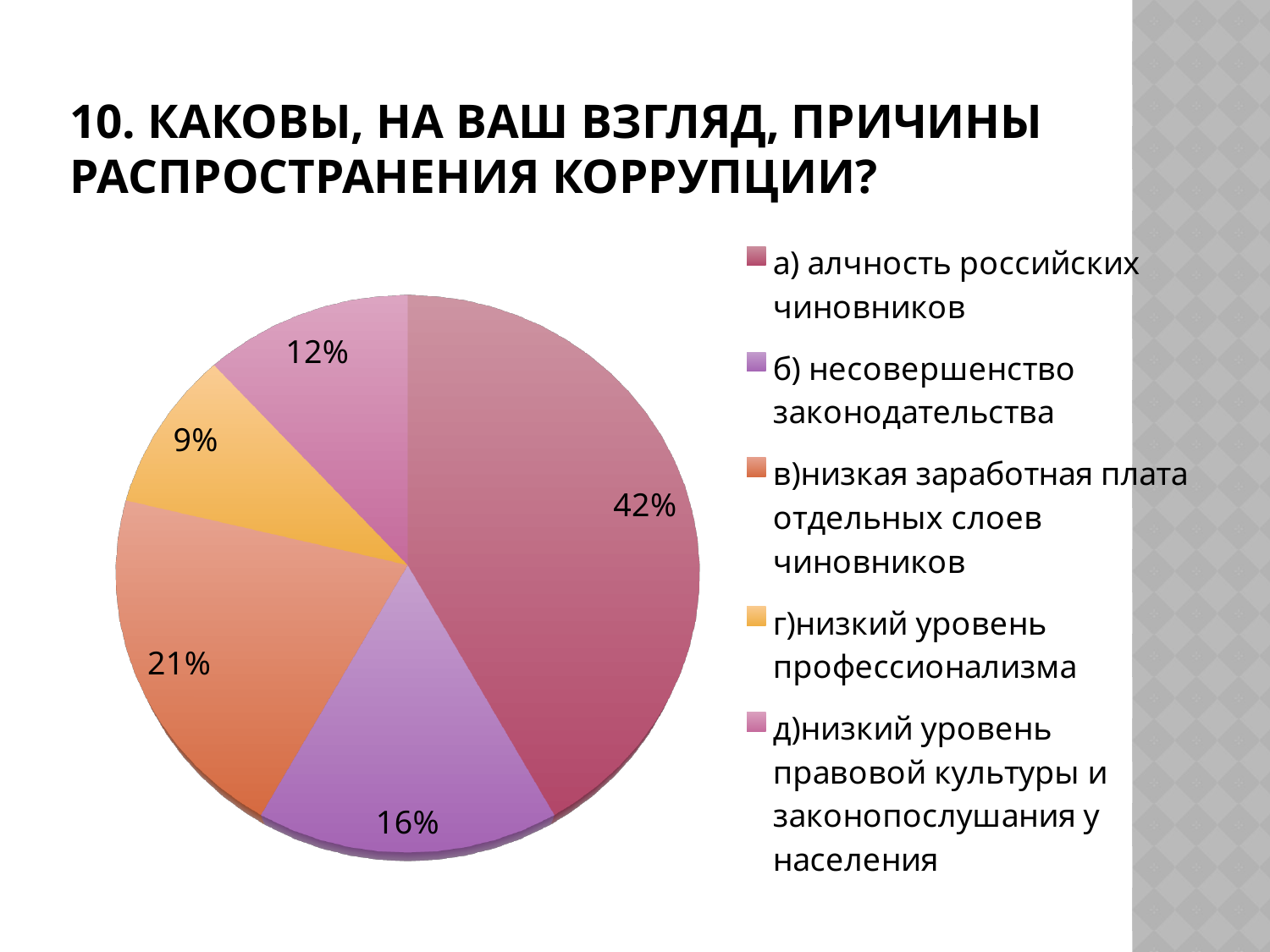
How many slices does the pie chart have? 5 What share of the pie is labelled for "б) несовершенство законодательства"? 16% How many entries does the legend list? 5 Which is larger: the slice for "б) несовершенство законодательства" or the slice for "д) низкий уровень правовой культуры и законопослушания у населения"? б) несовершенство законодательства What share of the pie is labelled for "г) низкий уровень профессионализма"? 9% What share of the pie is labelled for "в) низкая заработная плата отдельных слоев чиновников"? 21% Which category has the smallest slice of the pie? г) низкий уровень профессионализма What share of the pie is labelled for "д) низкий уровень правовой культуры и законопослушания у населения"? 12% What share of the pie is labelled for "а) алчность российских чиновников"? 42% What is the difference in percentage points between the slice for "а) алчность российских чиновников" and the slice for "в) низкая заработная плата отдельных слоев чиновников"? 21 What kind of chart is shown on the slide? pie chart Which category has the largest slice of the pie? а) алчность российских чиновников